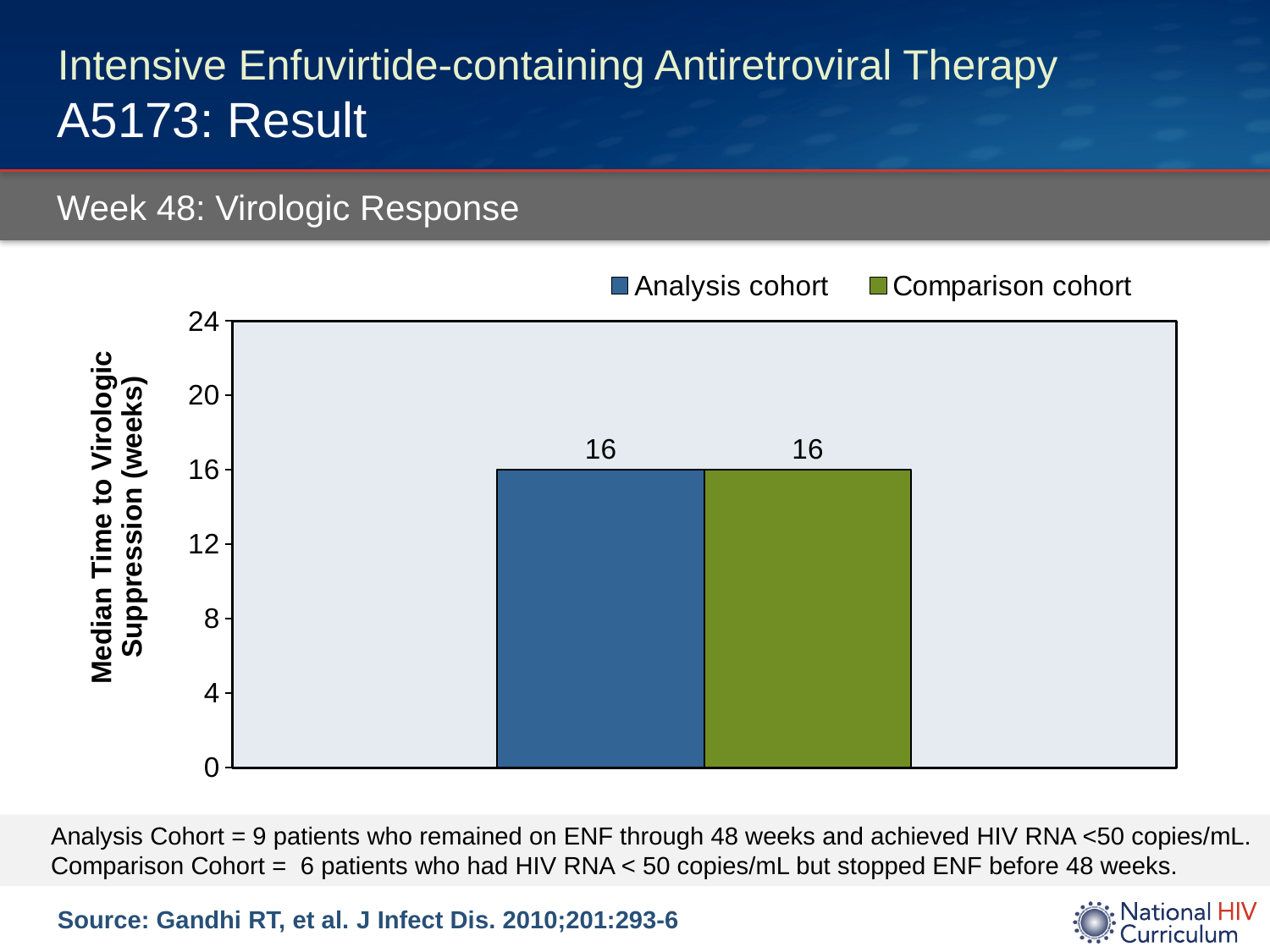
Is the value for the Analysis cohort greater or less than 12? greater What is the difference in median time to virologic suppression between the Analysis cohort and the Comparison cohort? 0 What kind of chart is shown on the slide? bar chart What is the median time to virologic suppression for the Comparison cohort? 16 Is the value for the Analysis cohort larger than, smaller than, or equal to the value for the Comparison cohort? equal How many series does the legend list? 2 Which colour represents the Comparison cohort in the legend? green How many bars are plotted in the chart? 2 What is the label of the vertical axis? Median Time to Virologic Suppression (weeks) What is the median time to virologic suppression for the Analysis cohort? 16 What is the highest value shown on the vertical axis? 24 Is the value for the Comparison cohort greater or less than 20? less